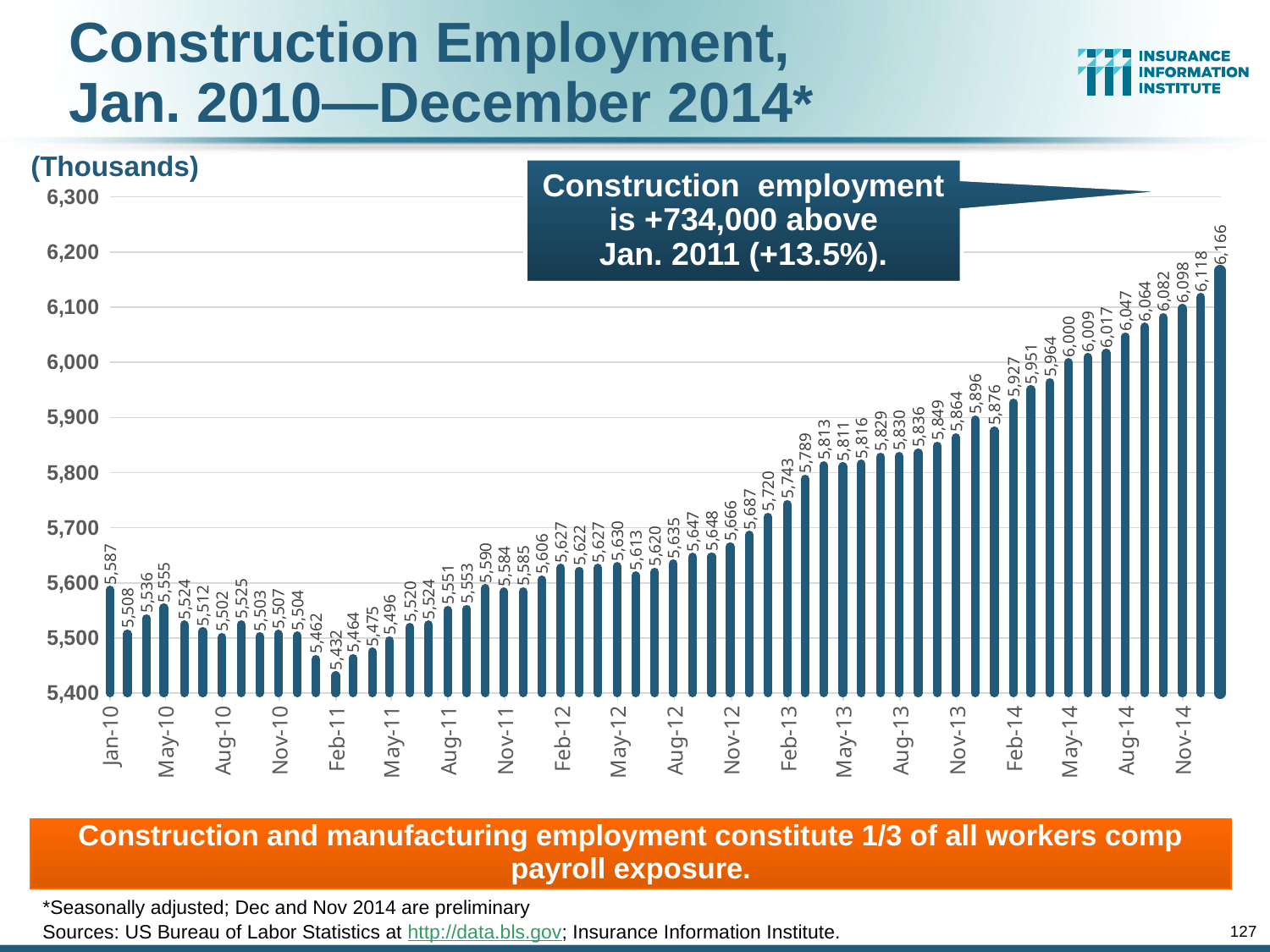
Do the values generally rise or fall from Feb-11 to Nov-14? Rise What is the lowest value shown on the chart? 5,432 What kind of chart is shown on the slide? Bar chart What is the highest value shown on the chart? 6,166 How many monthly bars are plotted on the chart? 60 What is the construction employment value for Jan-10? 5,587 Which is larger, the value for May-13 or the value for Aug-13? Aug-13 Is the value for Feb-14 greater or less than 5,900? greater What is the construction employment value for Nov-14? 6,118 What is the construction employment value for Nov-13? 5,896 How much higher is the value for Nov-14 than the value for Jan-10? 531 What is the construction employment value for Feb-11? 5,464